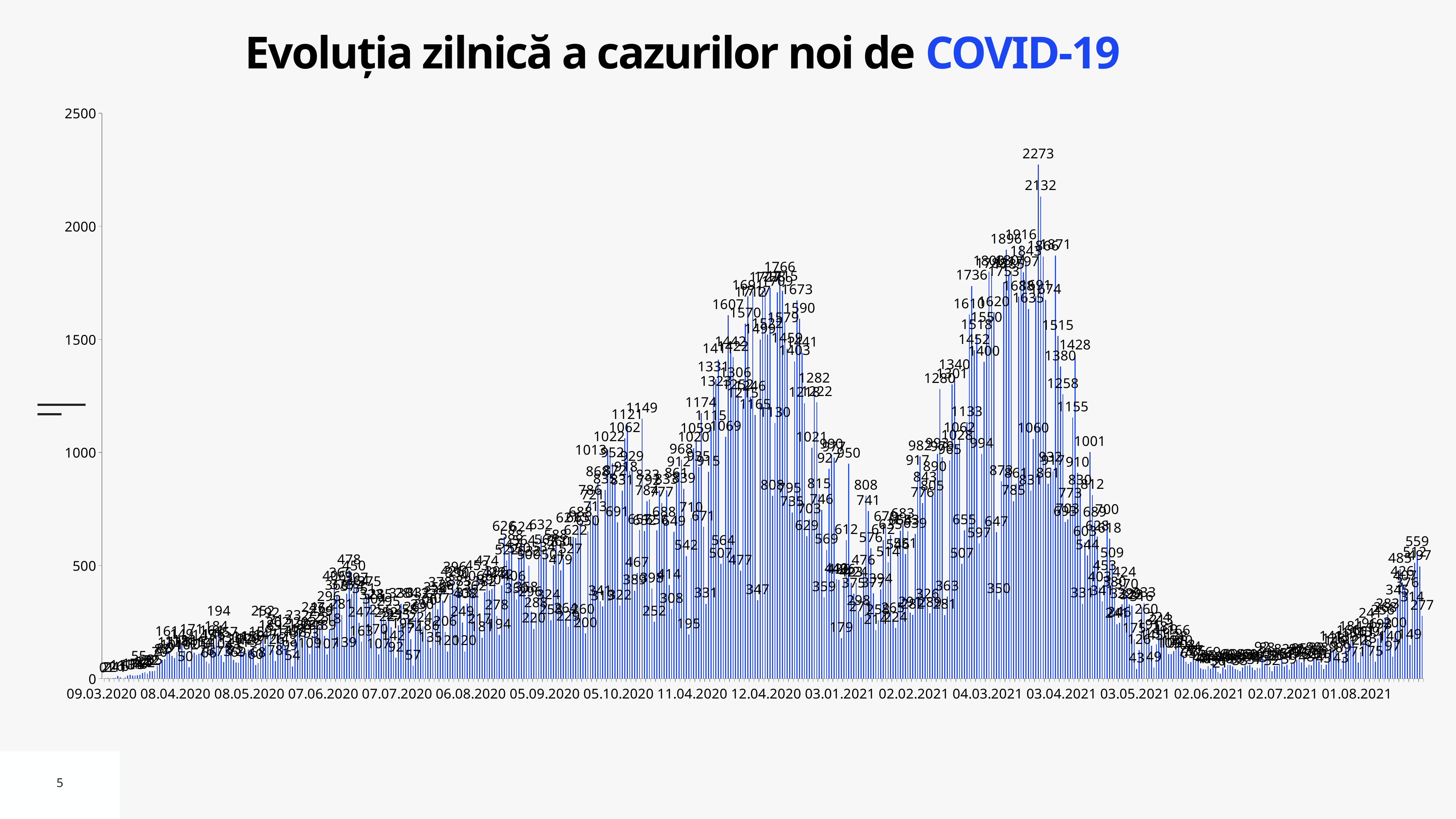
Do the values rise or fall between 03.04.2021 and 02.06.2021? fall What kind of chart is shown on the slide? bar chart What is the second-highest labelled value on the chart, next to the 2273 peak? 2132 What is the title of the chart? Evoluția zilnică a cazurilor noi de COVID-19 Are the values around 02.06.2021 greater or less than 500? less What is the highest daily value shown on the chart? 2273 What is the difference between the two highest labelled values, 2273 and 2132? 141 How many date labels are shown on the horizontal axis? 18 Do the values rise or fall from 01.08.2021 to the end of the chart? rise Is the value of the tallest bar greater or less than 2000? greater What is the highest value shown on the vertical axis? 2500 Which is larger: the peak of the wave around 12.04.2020 (1766) or the peak of the wave around 03.04.2021 (2273)? 2273